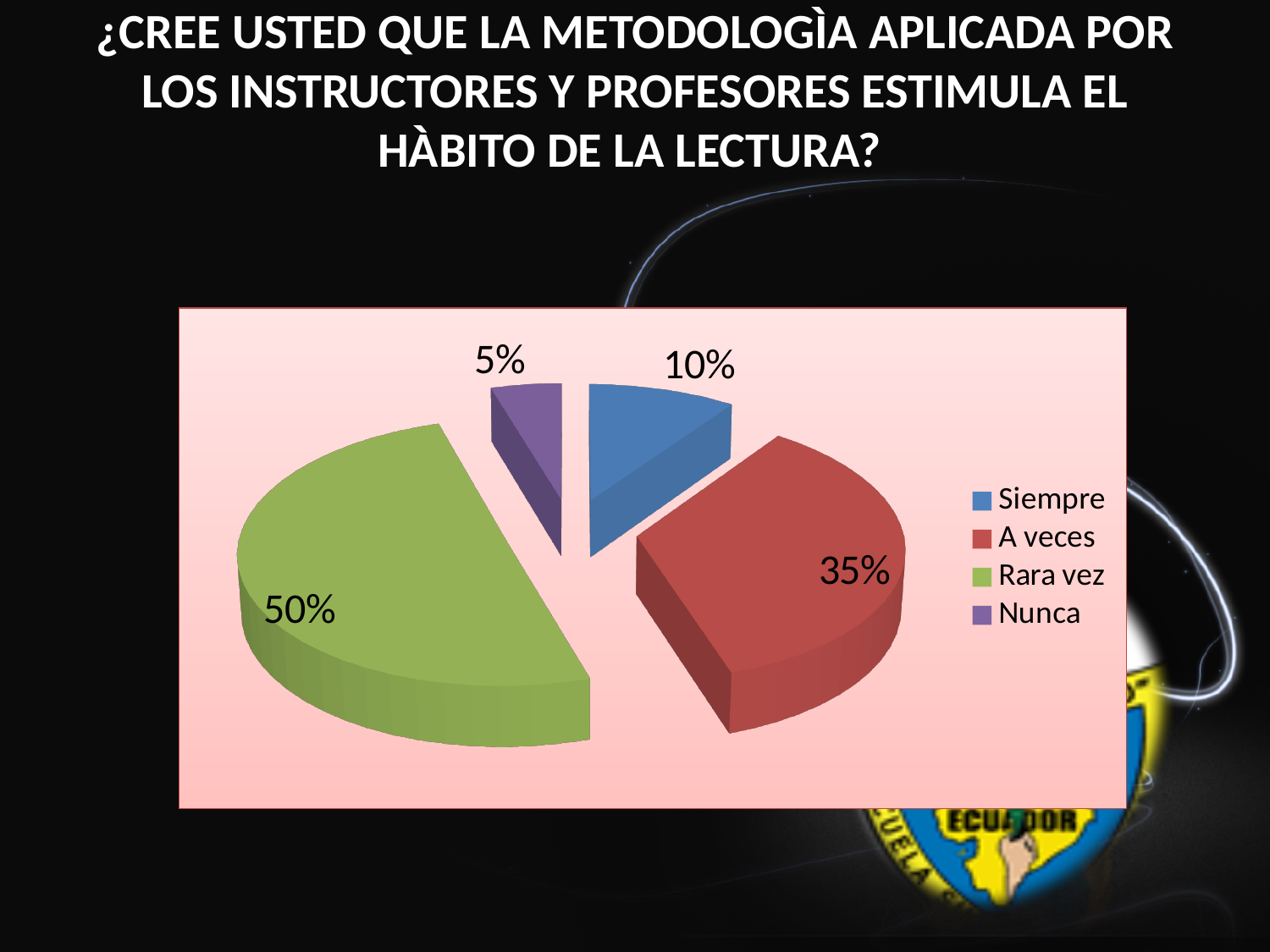
What percentage is shown for A veces? 35% What percentage is shown for Nunca? 5% What percentage is shown for Rara vez? 50% What kind of chart is shown on the slide? pie chart How many categories does the pie chart have? 4 What is the difference in percentage points between Rara vez and A veces? 15 What colour is the slice for Rara vez? green Which category has the largest slice of the pie? Rara vez What percentage is shown for Siempre? 10% Which category is listed first in the legend? Siempre Which is larger, the slice for Siempre or the slice for A veces? A veces Which category has the smallest slice of the pie? Nunca